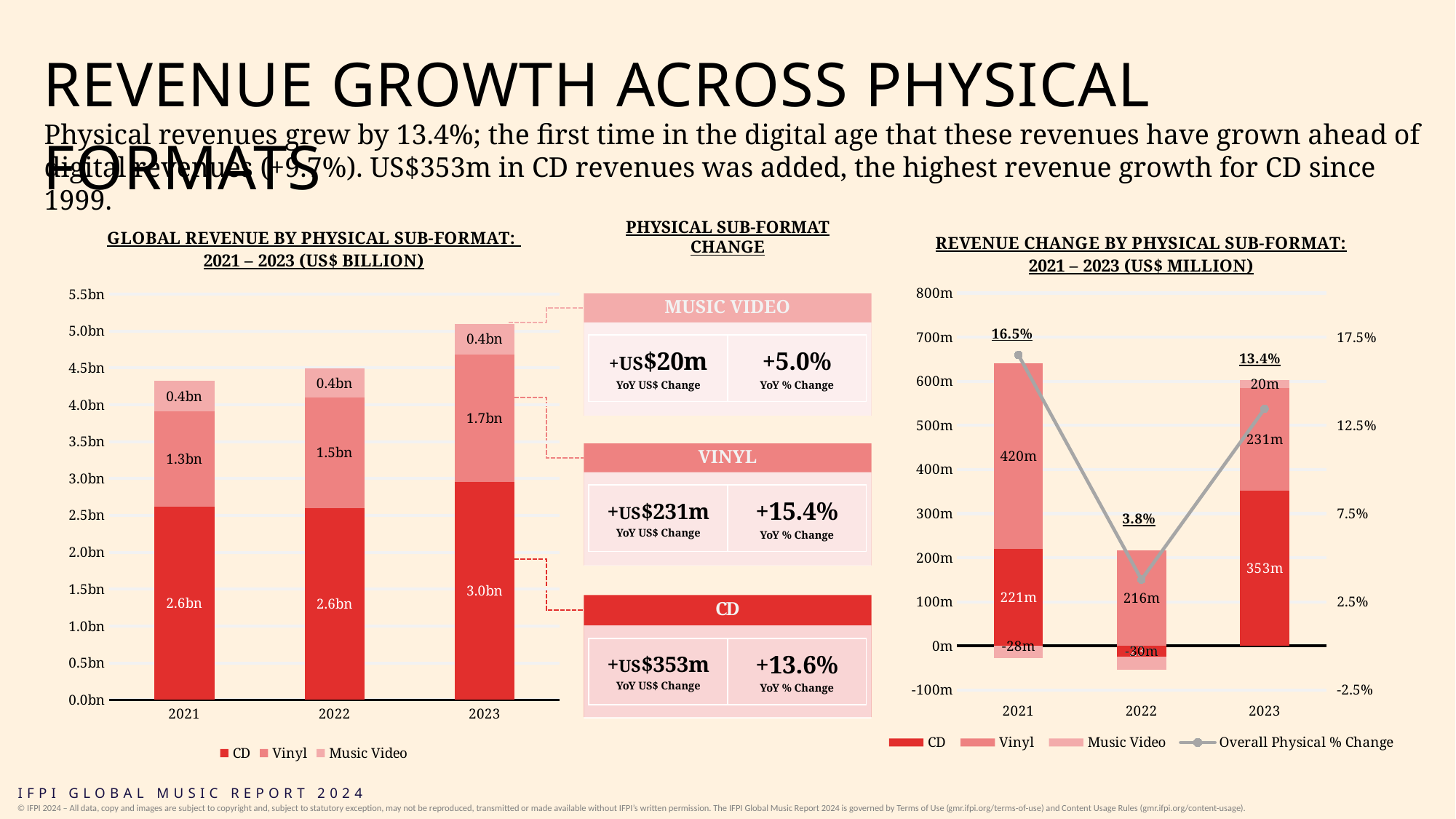
In the 'Revenue Change by Physical Sub-Format' chart, which is larger for 2023: the CD value or the Vinyl value? CD In the 'Global Revenue by Physical Sub-Format' chart, does the Vinyl value rise or fall from 2021 to 2023? Rises In the chart titled 'Revenue Change by Physical Sub-Format: 2021 – 2023 (US$ Million)', what is the Vinyl value for 2021? 420m In the chart titled 'Global Revenue by Physical Sub-Format: 2021 – 2023 (US$ Billion)', what is the Vinyl value for 2021? 1.3bn How many series does the legend of the 'Global Revenue by Physical Sub-Format' chart list? 3 In the 'Revenue Change by Physical Sub-Format' chart, what is the Overall Physical % Change for 2022? 3.8% What kind of chart is the 'Global Revenue by Physical Sub-Format' chart on the left of the slide? Stacked bar chart How many series does the legend of the 'Revenue Change by Physical Sub-Format' chart list? 4 In the 'Global Revenue by Physical Sub-Format' chart, what is the difference between the Vinyl value for 2023 and the Vinyl value for 2021? 0.4bn In the 'Revenue Change by Physical Sub-Format' chart, which year has the highest Overall Physical % Change? 2021 In the chart titled 'Revenue Change by Physical Sub-Format: 2021 – 2023 (US$ Million)', what is the CD value for 2023? 353m In the chart titled 'Global Revenue by Physical Sub-Format: 2021 – 2023 (US$ Billion)', what is the CD value for 2023? 3.0bn